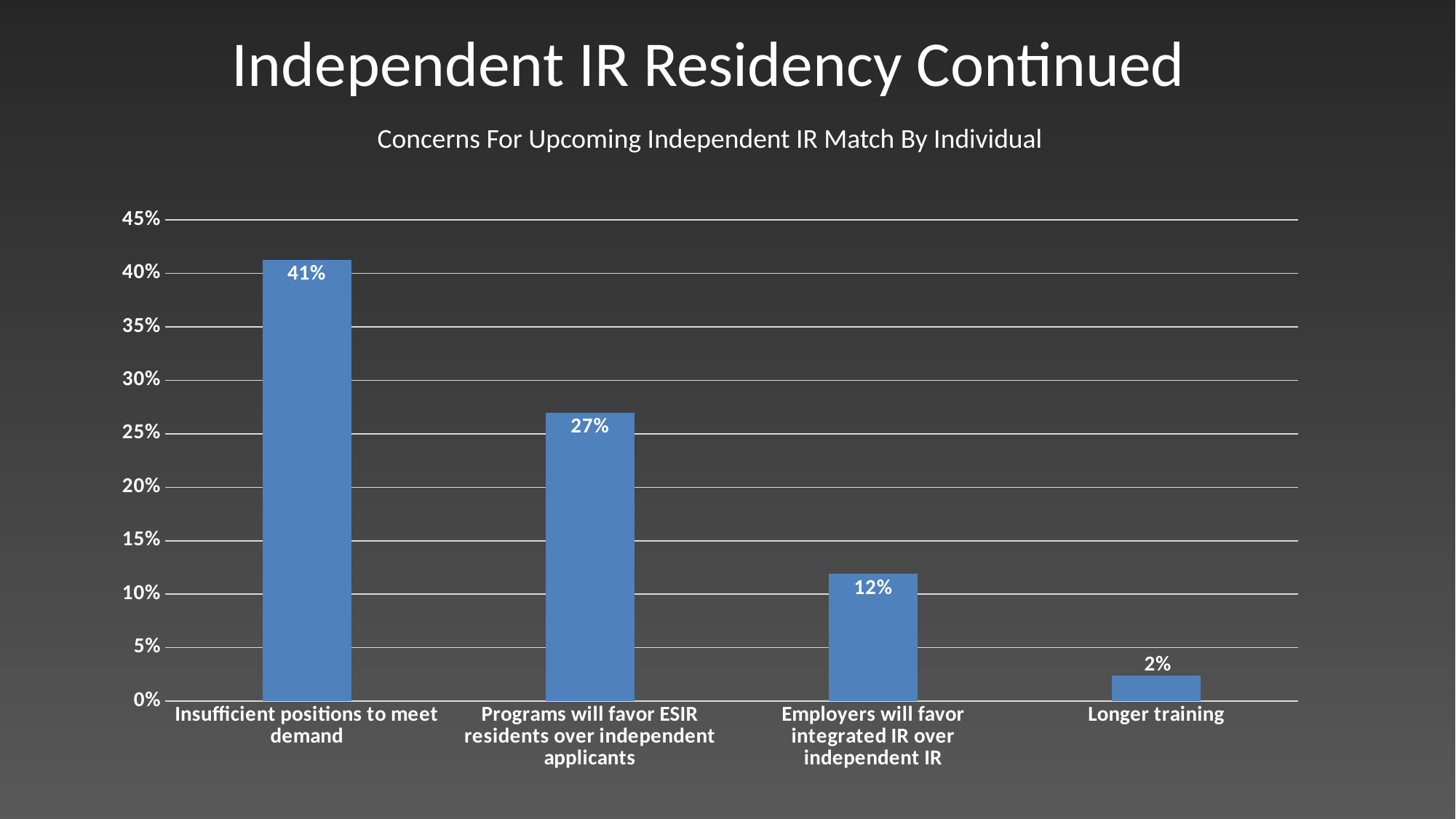
Which category has the highest value? Insufficient positions to meet demand Which category has the lowest value? Longer training Which is larger: the value for "Employers will favor integrated IR over independent IR" or the value for "Longer training"? Employers will favor integrated IR over independent IR What is the value for "Insufficient positions to meet demand"? 41% How many categories are shown in the chart? 4 What is the value for "Employers will favor integrated IR over independent IR"? 12% What is the title of the chart? Concerns For Upcoming Independent IR Match By Individual What is the value for "Programs will favor ESIR residents over independent applicants"? 27% What is the value for "Longer training"? 2% Is the value for "Programs will favor ESIR residents over independent applicants" greater or less than 25%? greater What kind of chart is shown on the slide? Bar chart What is the difference between the values for "Insufficient positions to meet demand" and "Programs will favor ESIR residents over independent applicants"? 14%